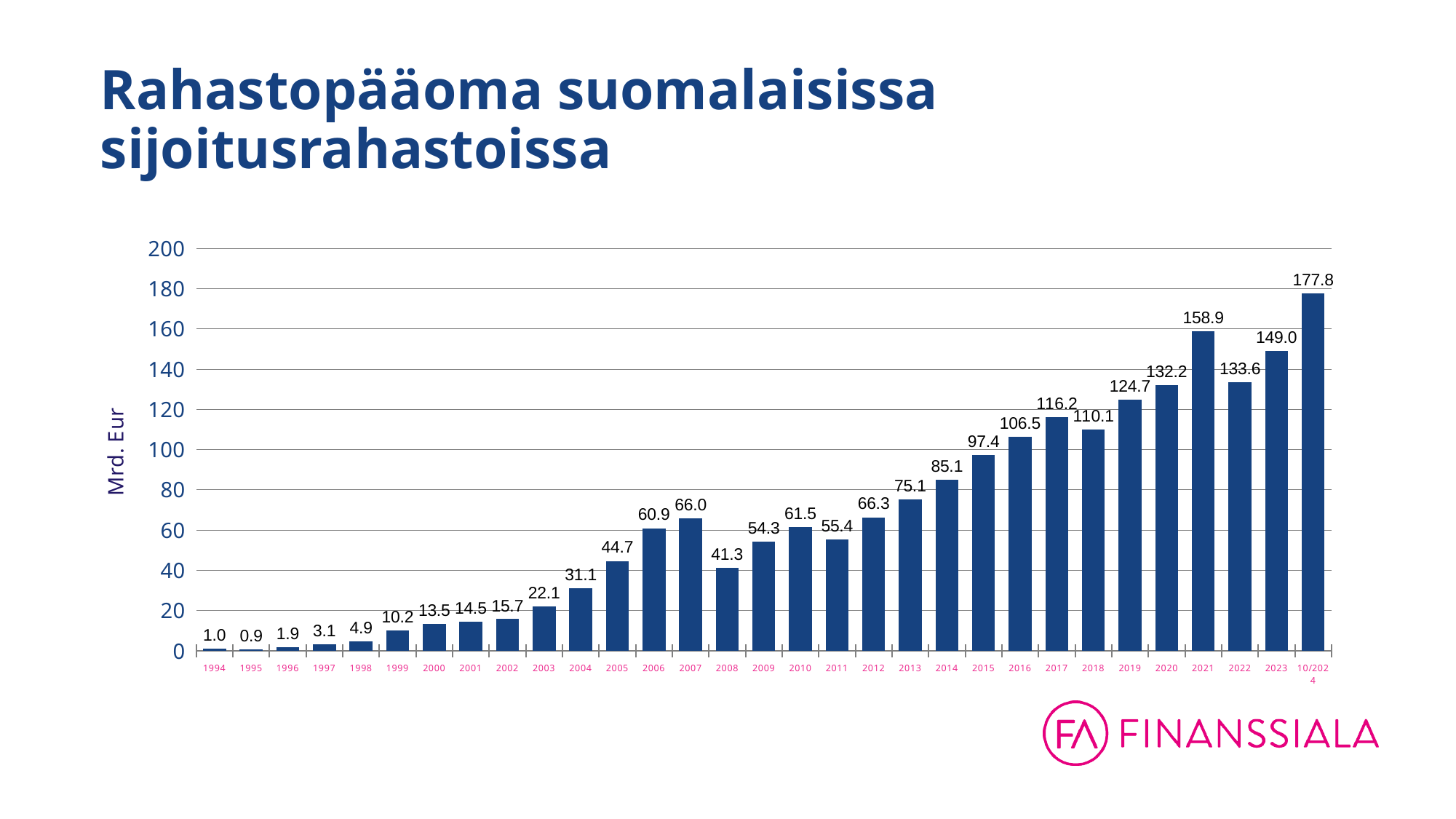
What is the value for 10/2024? 177.8 What is the difference between the values for 2023 and 2022? 15.4 Do the values generally rise or fall from 1994 to 10/2024? rise What is the label on the vertical axis? Mrd. Eur What is the value for 2008? 41.3 What kind of chart is shown on the slide? bar chart How many bars are shown in the chart? 31 Which is larger, the value for 2007 or the value for 2012? 2012 Which year has the lowest value? 1995 What is the value for 2021? 158.9 Which category has the highest value? 10/2024 Is the value for 2019 greater or less than 120? greater